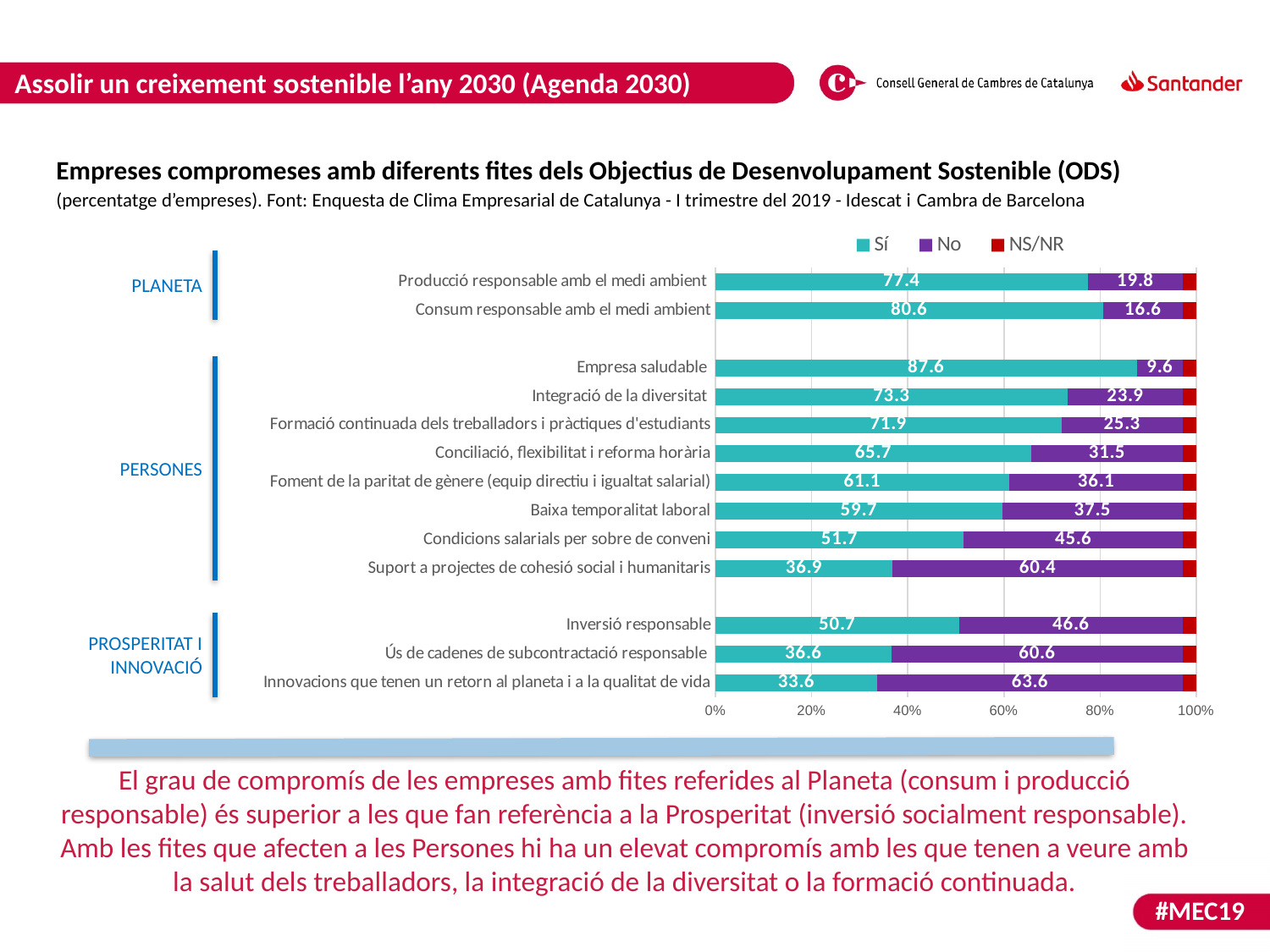
How many series does the legend list? 3 What is the Sí value for Empresa saludable? 87.6 Which category has the highest No value? Innovacions que tenen un retorn al planeta i a la qualitat de vida What is the Sí value for Inversió responsable? 50.7 What kind of chart is shown on the slide? Stacked bar chart How many categories (bars) are shown in the chart? 13 What is the No value for Baixa temporalitat laboral? 37.5 Which category has the lowest Sí value? Innovacions que tenen un retorn al planeta i a la qualitat de vida Is the Sí value for Condicions salarials per sobre de conveni greater or less than 60%? less Which category has the highest Sí value? Empresa saludable What is the difference between the Sí values for Consum responsable amb el medi ambient and Producció responsable amb el medi ambient? 3.2 Which has a larger Sí value: Integració de la diversitat or Formació continuada dels treballadors i pràctiques d'estudiants? Integració de la diversitat